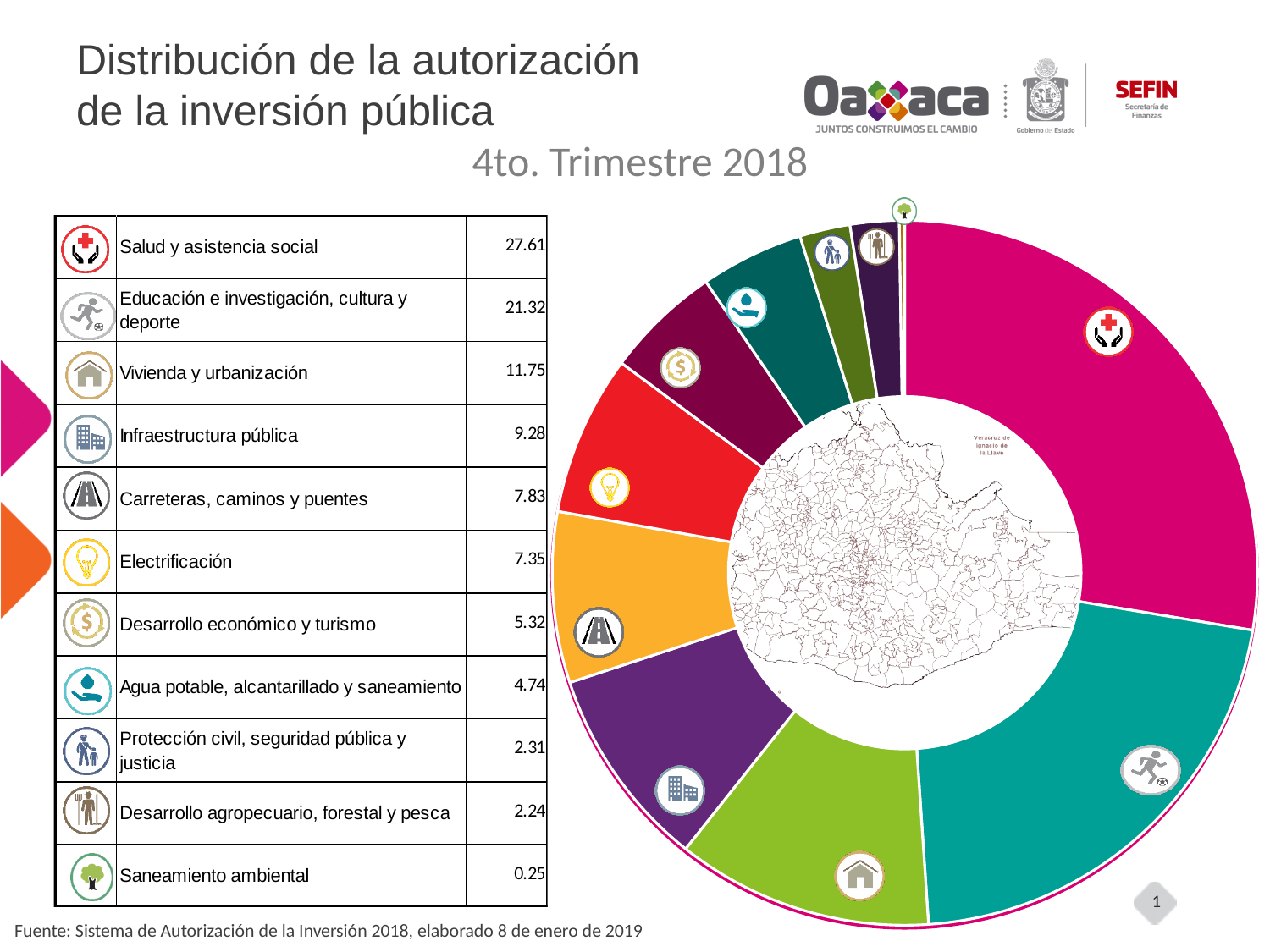
Which category has the lowest value? Saneamiento ambiental What is the value for Vivienda y urbanización? 11.75 What is the difference between Desarrollo económico y turismo and Desarrollo agropecuario, forestal y pesca? 3.08 How many categories are shown in the chart? 11 What kind of chart is shown on the slide? Doughnut (pie) chart What period does the chart cover, according to the subtitle? 4to. Trimestre 2018 Which category has the highest value? Salud y asistencia social What is the difference between Salud y asistencia social and Educación e investigación, cultura y deporte? 6.29 What is the value for Salud y asistencia social? 27.61 What is the value for Agua potable, alcantarillado y saneamiento? 4.74 Which is larger, Infraestructura pública or Carreteras, caminos y puentes? Infraestructura pública What is the value for Electrificación? 7.35